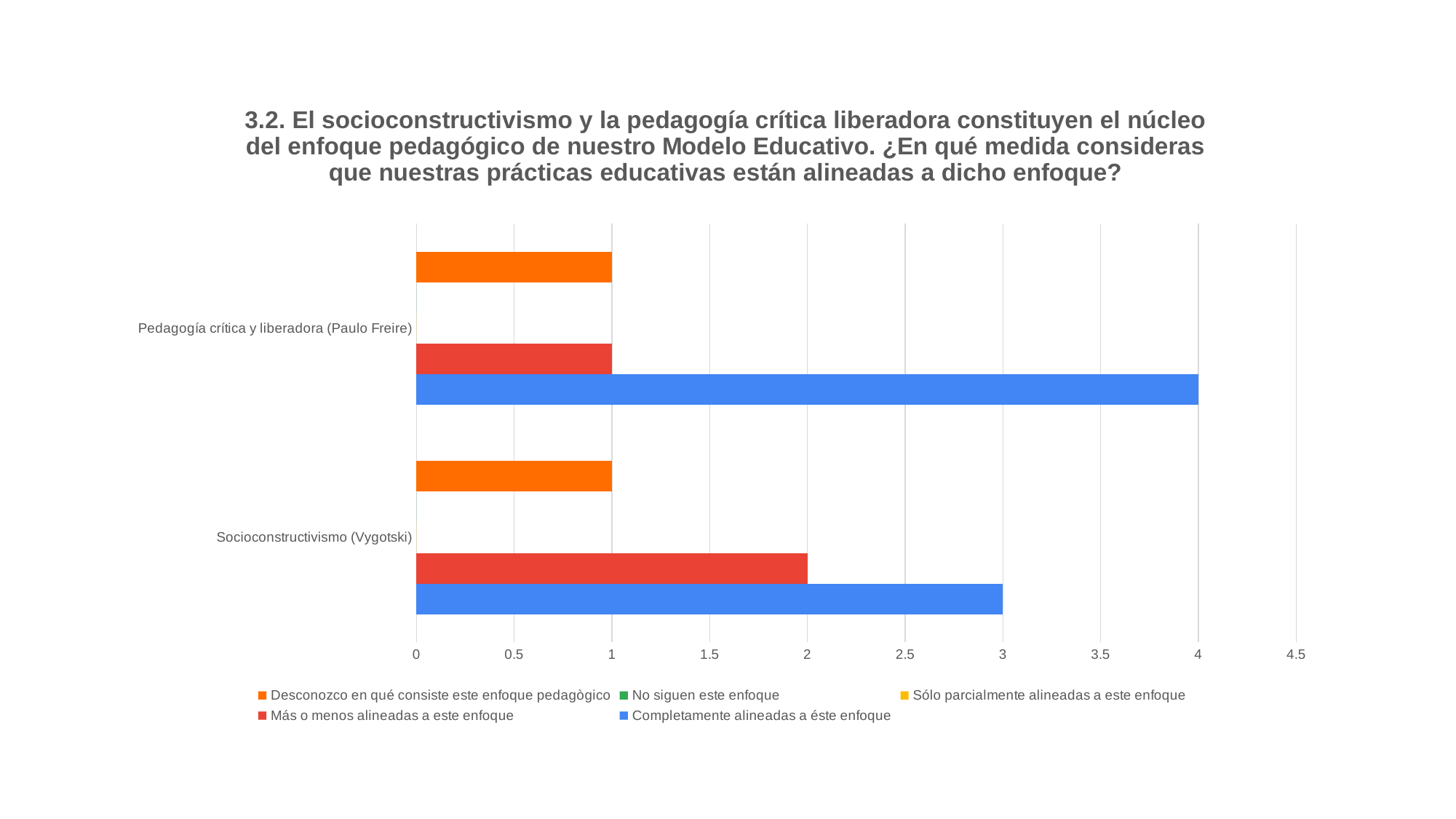
What is the value of "Completamente alineadas a éste enfoque" for Pedagogía crítica y liberadora (Paulo Freire)? 4 What is the value of "Más o menos alineadas a este enfoque" for Pedagogía crítica y liberadora (Paulo Freire)? 1 What is the value of "Desconozco en qué consiste este enfoque pedagògico" for Socioconstructivismo (Vygotski)? 1 What is the difference between the "Completamente alineadas a éste enfoque" values for Pedagogía crítica y liberadora (Paulo Freire) and Socioconstructivismo (Vygotski)? 1 What kind of chart is shown on the slide? bar chart How many series does the legend list? 5 What colour represents "Completamente alineadas a éste enfoque" in the legend? blue How many categories are shown on the vertical axis? 2 What is the value of "Completamente alineadas a éste enfoque" for Socioconstructivismo (Vygotski)? 3 Which category has the higher value for "Completamente alineadas a éste enfoque"? Pedagogía crítica y liberadora (Paulo Freire) What is the value of "Más o menos alineadas a este enfoque" for Socioconstructivismo (Vygotski)? 2 For Socioconstructivismo (Vygotski), which is larger: "Más o menos alineadas a este enfoque" or "Desconozco en qué consiste este enfoque pedagògico"? Más o menos alineadas a este enfoque